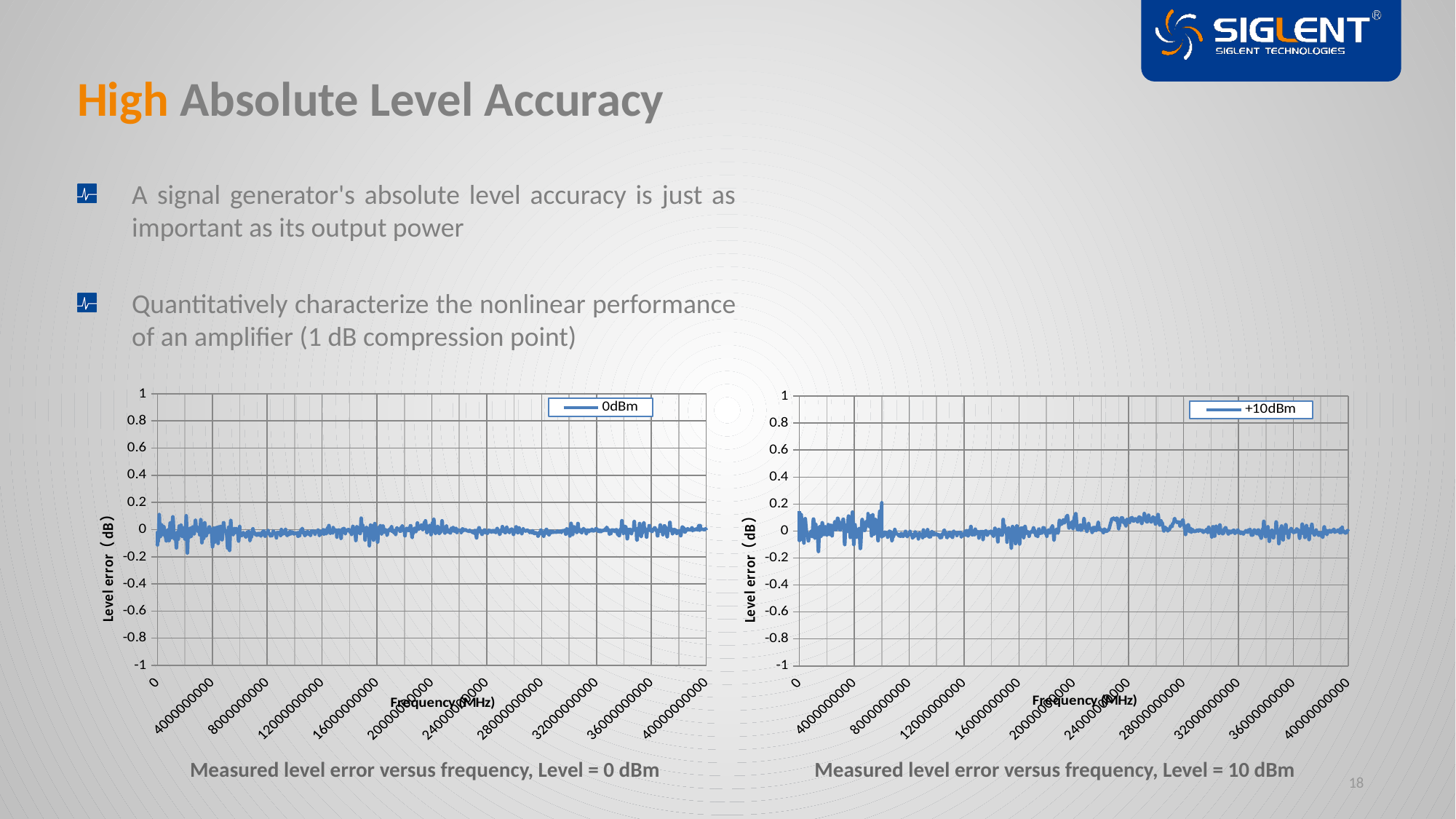
In the left chart (Level = 0 dBm), is the level error at a frequency of 8000000000 greater or less than -0.4? greater In the right chart (Level = 10 dBm), is the level error at a frequency of 24000000000 greater or less than 0.4? less How many series does the legend of the right chart (Level = 10 dBm) list? 1 In the right chart (Level = 10 dBm), is the level error at a frequency of 4000000000 greater or less than -0.6? greater What kind of chart is the right chart (Level = 10 dBm)? line chart What kind of chart is the left chart (Level = 0 dBm)? line chart How many series does the legend of the left chart (Level = 0 dBm) list? 1 What is the legend entry in the right chart (Level = 10 dBm)? +10dBm How many tick labels are shown on the x axis of the left chart (Level = 0 dBm)? 11 What is the highest value shown on the y axis of the right chart (Level = 10 dBm)? 1 What is the legend entry in the left chart (Level = 0 dBm)? 0dBm